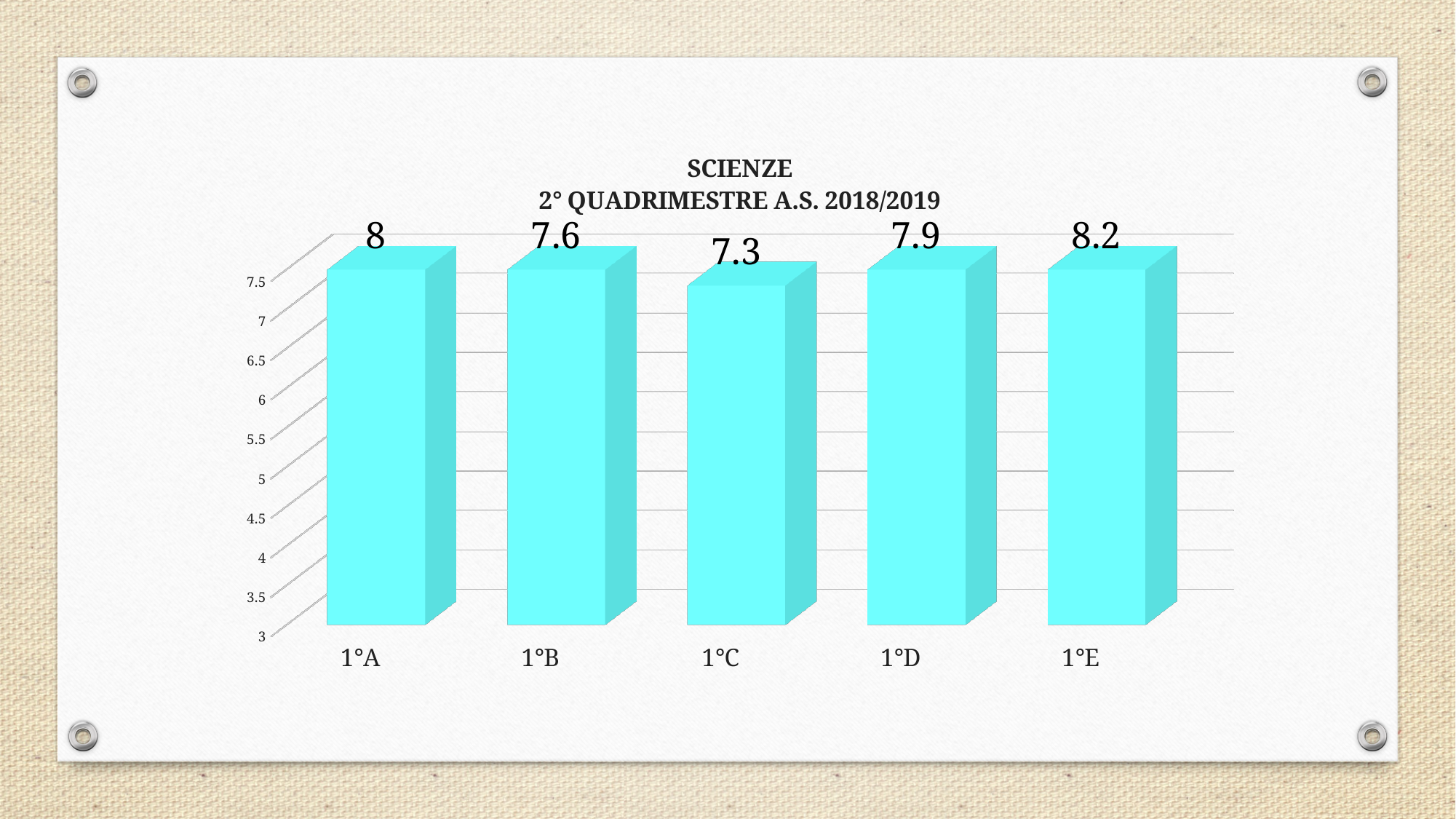
Which is larger, the value for 1°B or the value for 1°D? 1°D What is the difference between the values for 1°E and 1°C? 0.9 What is the difference between the values for 1°A and 1°B? 0.4 What is the value for 1°A? 8 Which class has the lowest value? 1°C How many classes are shown on the chart? 5 Which class has the highest value? 1°E What is the value for 1°E? 8.2 What kind of chart is shown on the slide? bar chart What is the title of the chart? SCIENZE 2° QUADRIMESTRE A.S. 2018/2019 Is the value for 1°C greater or less than 7.5? less What is the value for 1°C? 7.3